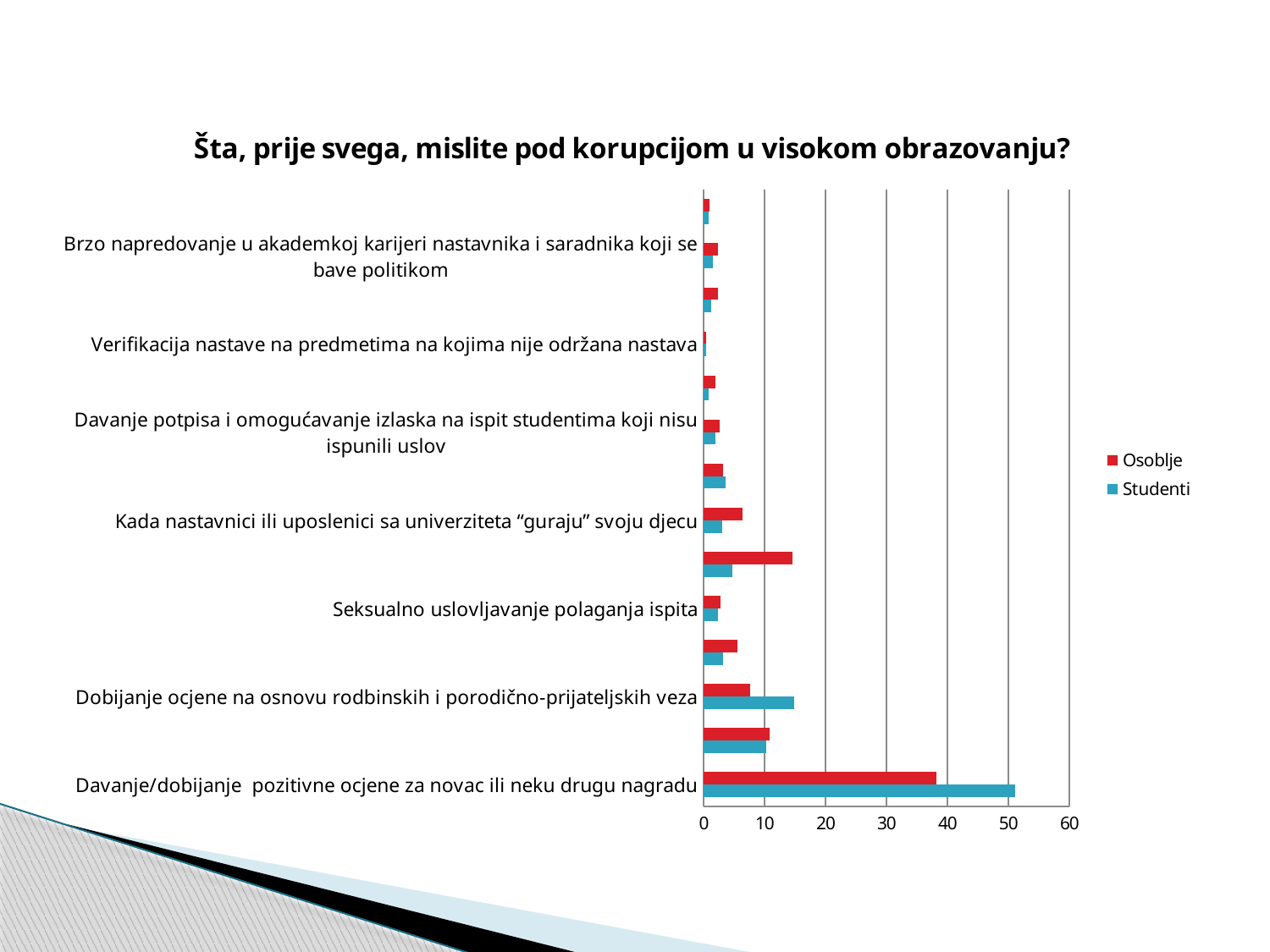
For "Davanje/dobijanje pozitivne ocjene za novac ili neku drugu nagradu", which series has the larger value, Osoblje or Studenti? Studenti For "Dobijanje ocjene na osnovu rodbinskih i porodično-prijateljskih veza", which series has the larger value, Osoblje or Studenti? Studenti Which category has the highest value for the Studenti series? Davanje/dobijanje pozitivne ocjene za novac ili neku drugu nagradu What is the title of the chart? Šta, prije svega, mislite pod korupcijom u visokom obrazovanju? For "Kada nastavnici ili uposlenici sa univerziteta “guraju” svoju djecu", which series has the larger value, Osoblje or Studenti? Osoblje What are the two series named in the legend? Osoblje and Studenti Is the Osoblje value for "Davanje/dobijanje pozitivne ocjene za novac ili neku drugu nagradu" greater or less than 30? greater Is the Studenti value for "Dobijanje ocjene na osnovu rodbinskih i porodično-prijateljskih veza" greater or less than 10? greater Which category has the highest value for the Osoblje series? Davanje/dobijanje pozitivne ocjene za novac ili neku drugu nagradu Is the Studenti value for "Davanje/dobijanje pozitivne ocjene za novac ili neku drugu nagradu" greater or less than 40? greater How many series does the legend list? 2 What kind of chart is shown on the slide? bar chart